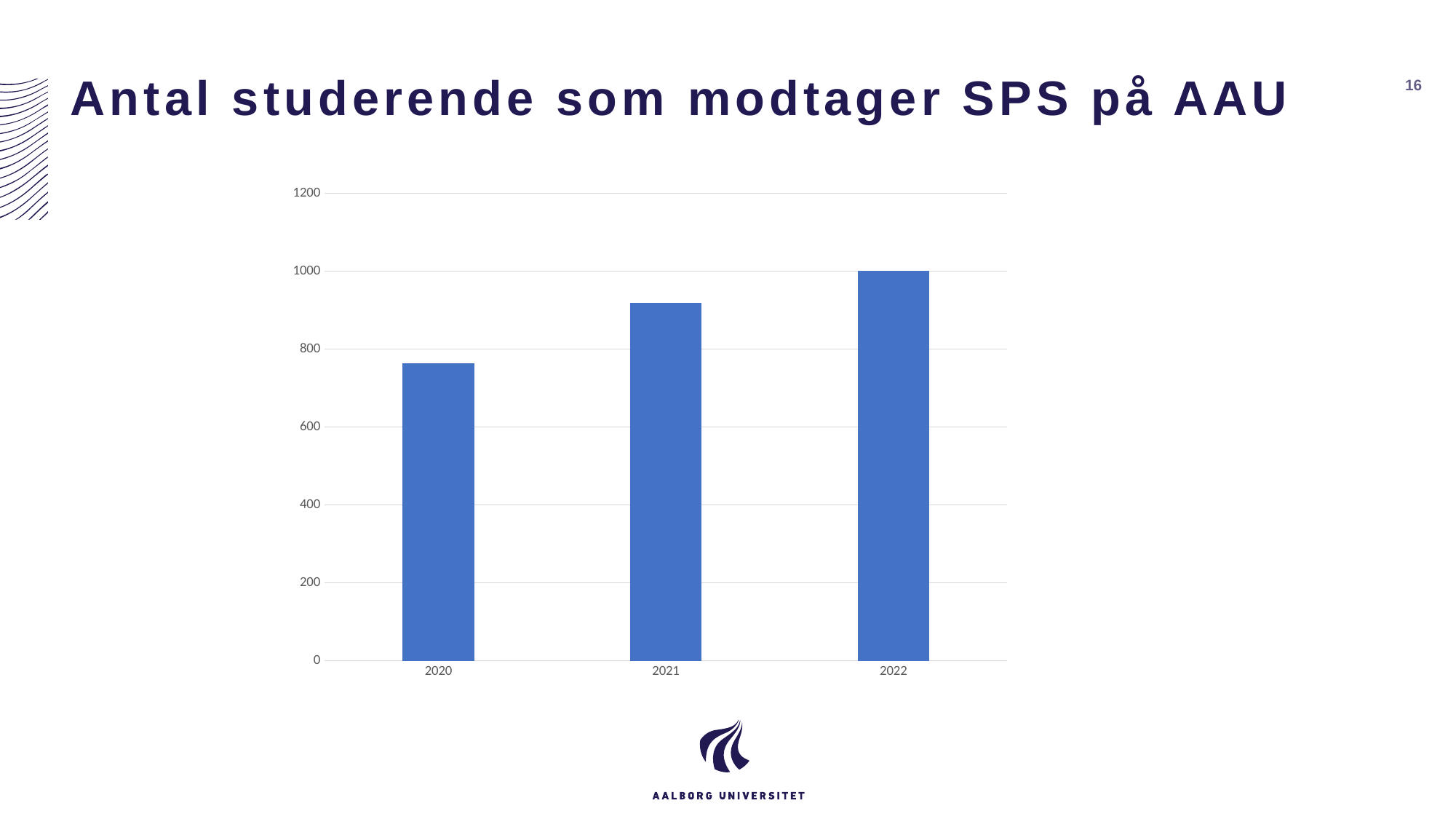
Which is larger, the value for 2021 or the value for 2020? 2021 What is the value for 2022? 1000 How many years are shown on the x axis of the chart? 3 Which year has the highest number of students receiving SPS? 2022 What is the title of the chart on the slide? Antal studerende som modtager SPS på AAU Is the value for 2020 greater or less than 800? less Do the values rise or fall from 2020 to 2022? rise What kind of chart is shown on the slide? Bar chart Which year has the lowest number of students receiving SPS? 2020 Is the value for 2021 greater or less than 1000? less Is the value for 2020 greater or less than 600? greater